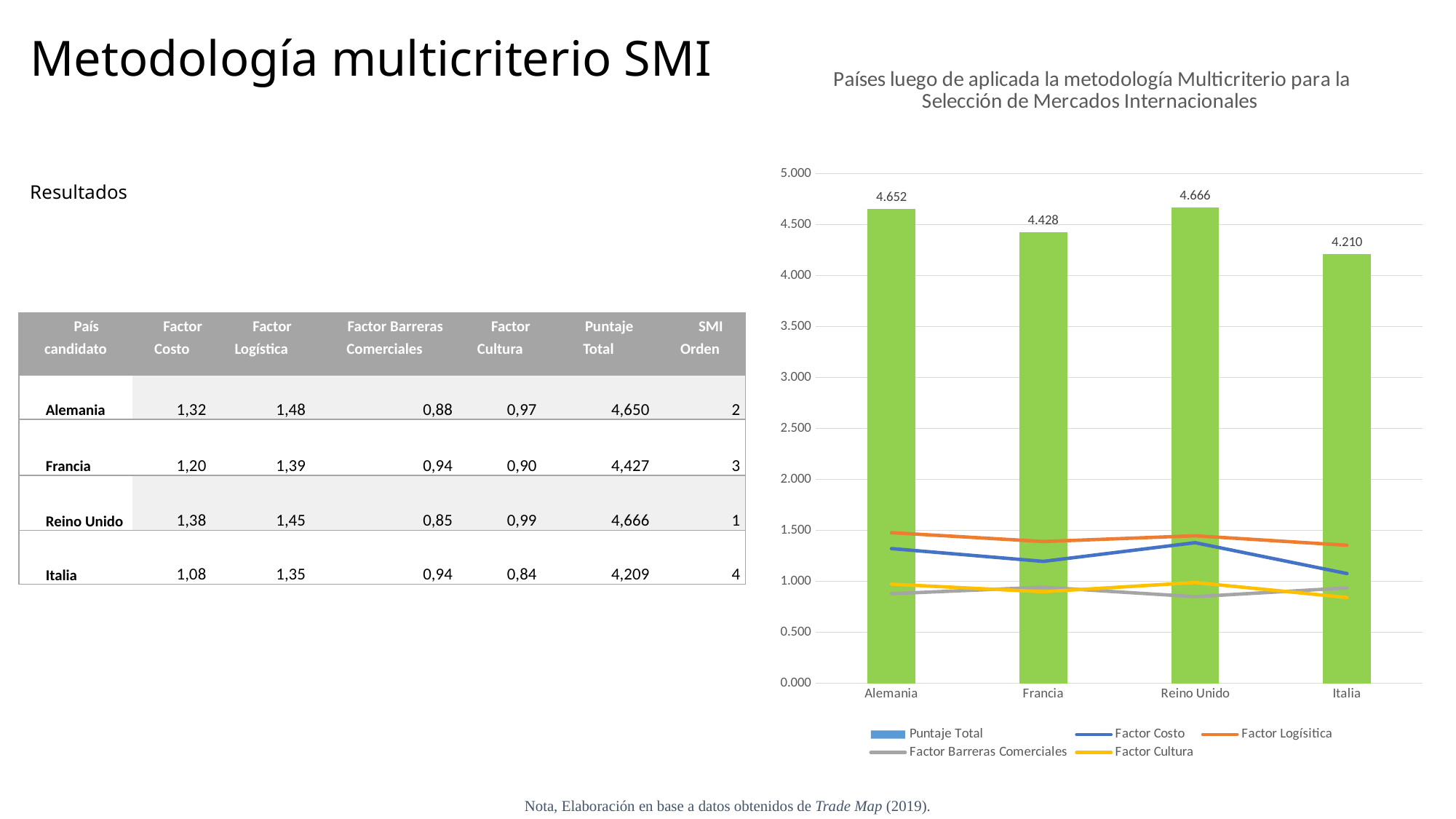
What kind of chart is shown on the slide? A combination chart with bars and lines Is the Factor Cultura value for Italia greater or less than 1.000? less What is the Puntaje Total value shown for Alemania? 4.652 Which country has the lowest Puntaje Total bar? Italia What is the difference between the Puntaje Total of Reino Unido and Alemania? 0.014 How many countries are shown on the x axis of the chart? 4 Is the Factor Logísitica value for Alemania greater or less than 1.000? greater What is the Puntaje Total value shown for Francia? 4.428 How many series does the chart legend list? 5 Which country has the highest Puntaje Total bar? Reino Unido What is the difference between the Puntaje Total of Alemania and Italia? 0.442 Which has a larger Puntaje Total, Francia or Italia? Francia